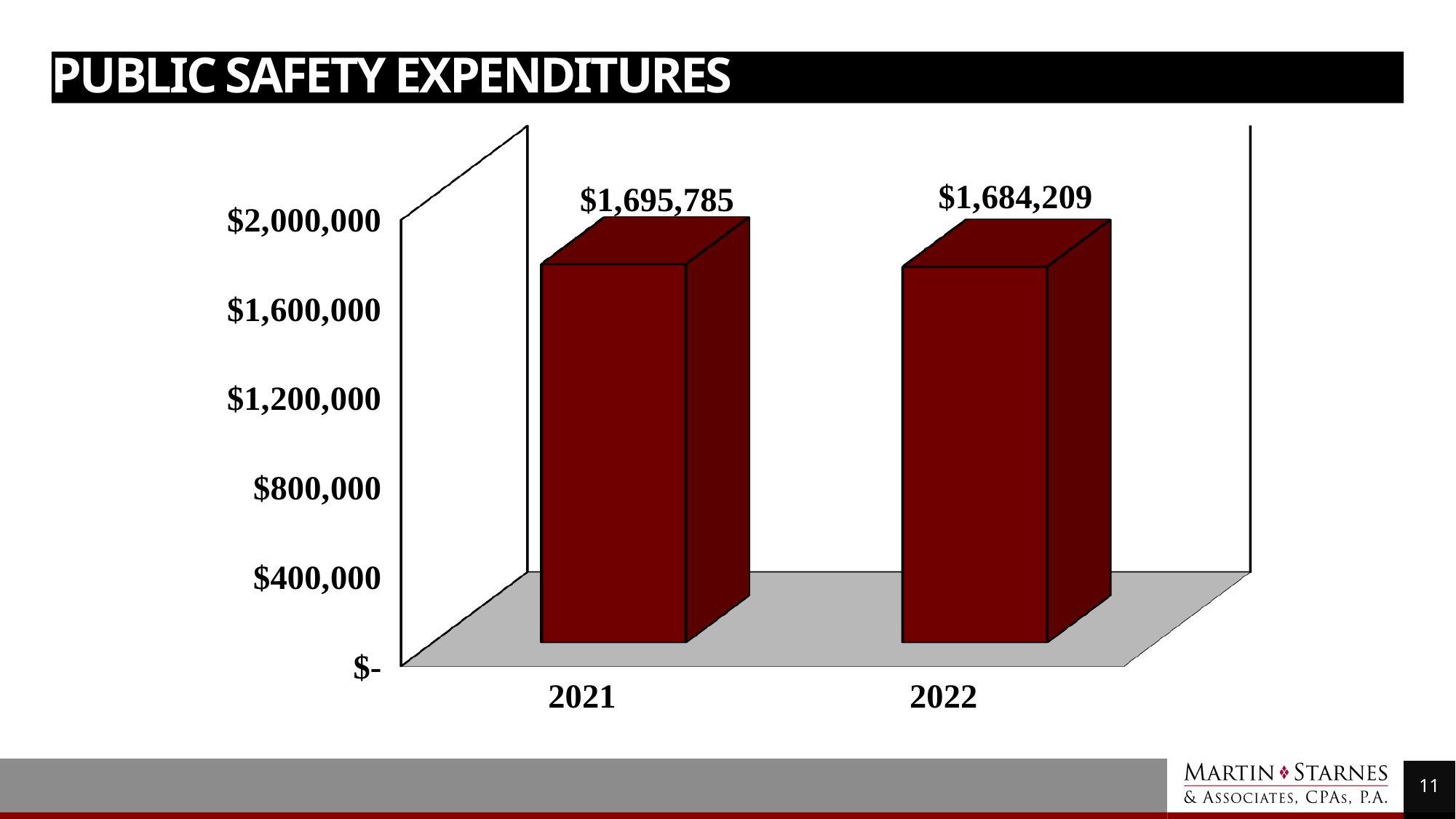
Which year has the higher public safety expenditure according to the data labels? 2021 What is the public safety expenditure value shown for 2021? $1,695,785 Is the value for 2021 greater or less than $2,000,000? less What kind of chart is shown on the slide? bar chart What is the title of the slide containing the chart? PUBLIC SAFETY EXPENDITURES What is the difference between the 2021 and 2022 public safety expenditures? $11,576 Do public safety expenditures rise or fall from 2021 to 2022? fall Which year has the lower public safety expenditure according to the data labels? 2022 What is the public safety expenditure value shown for 2022? $1,684,209 Is the value for 2022 greater or less than $1,600,000? greater Is the public safety expenditure for 2021 larger or smaller than for 2022? larger How many years are shown on the chart? 2